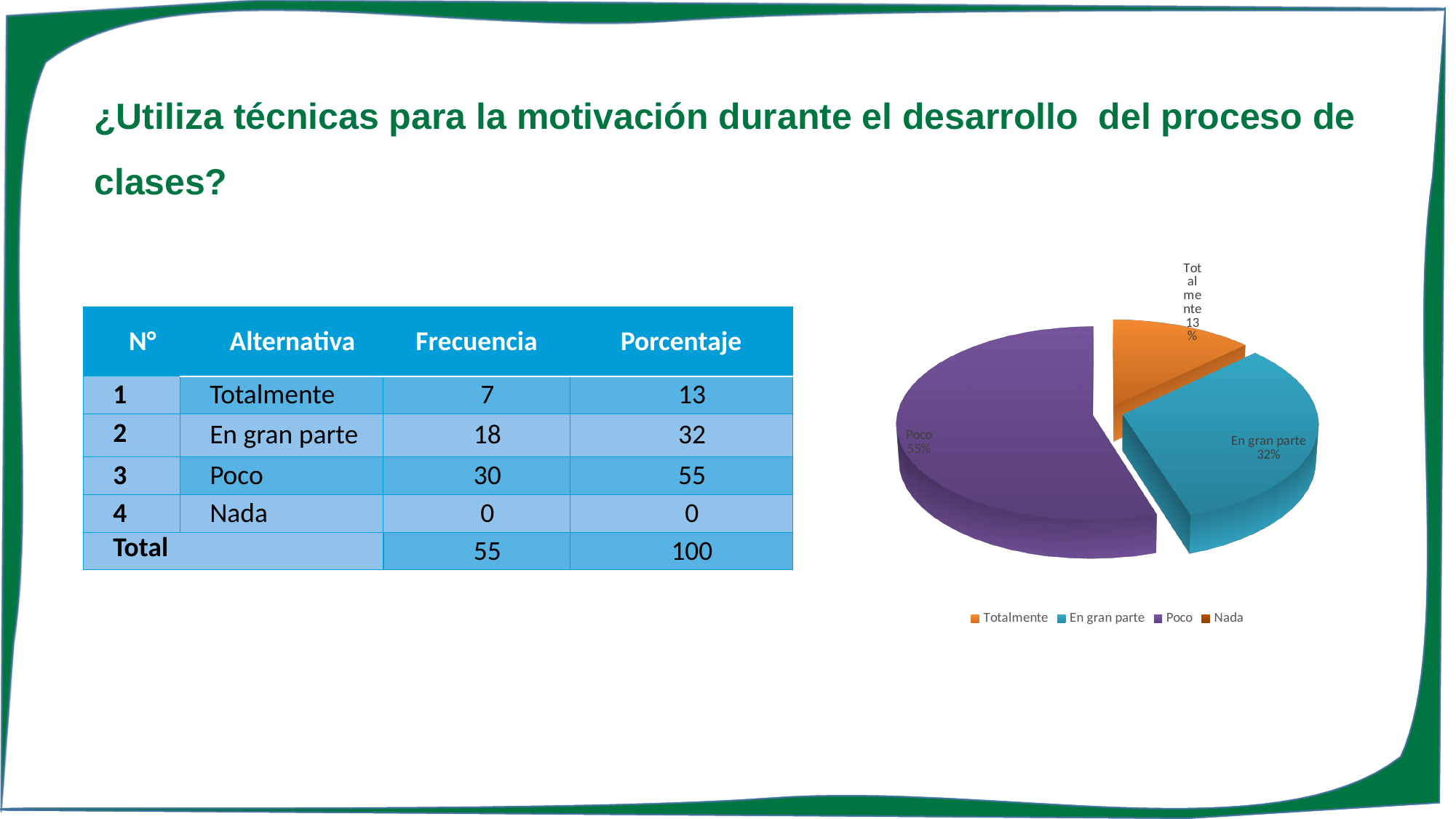
Which slice is larger, Totalmente or En gran parte? En gran parte Which labelled slice of the pie is the smallest? Totalmente What colour is the Poco slice of the pie? purple What share of the pie does the Totalmente slice represent? 13% What share of the pie does the Poco slice represent? 55% Which legend entry has no visible slice in the pie? Nada What share of the pie does the En gran parte slice represent? 32% What kind of chart is shown on the slide? pie chart What is the difference in percentage points between the Poco slice and the En gran parte slice? 23 What is the difference in percentage points between the En gran parte slice and the Totalmente slice? 19 How many entries does the pie chart's legend list? 4 Which category has the largest slice of the pie? Poco